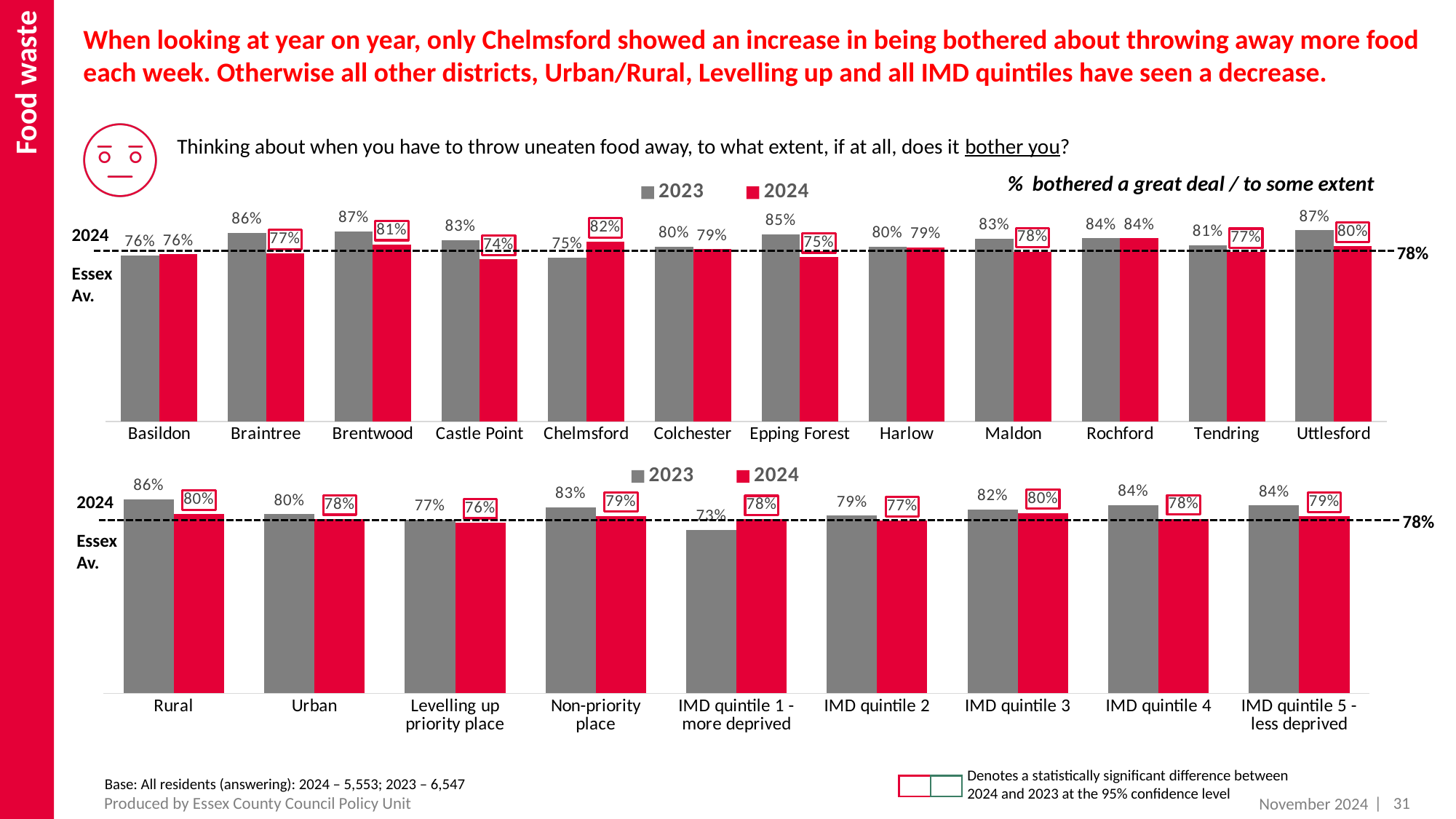
In the top chart (districts), what is the 2024 value for Chelmsford? 82% In the bottom chart, what is the difference between the 2023 and 2024 values for Rural? 6 percentage points What value does the dashed Essex average line mark on both charts? 78% In the top chart (districts), how many districts are shown on the x axis? 12 In the top chart (districts), which is larger for Chelmsford: the 2023 value or the 2024 value? 2024 In the top chart (districts), which district has the lowest 2024 value? Castle Point In the bottom chart, which category has the lowest 2023 value? IMD quintile 1 - more deprived What type of chart is used on this slide? Bar chart In the bottom chart, what is the 2024 value for IMD quintile 1 - more deprived? 78% In the top chart (districts), what is the 2023 value for Epping Forest? 85% In the bottom chart, how many series does the legend list? 2 In the top chart (districts), what is the difference between the 2023 and 2024 values for Braintree? 9 percentage points